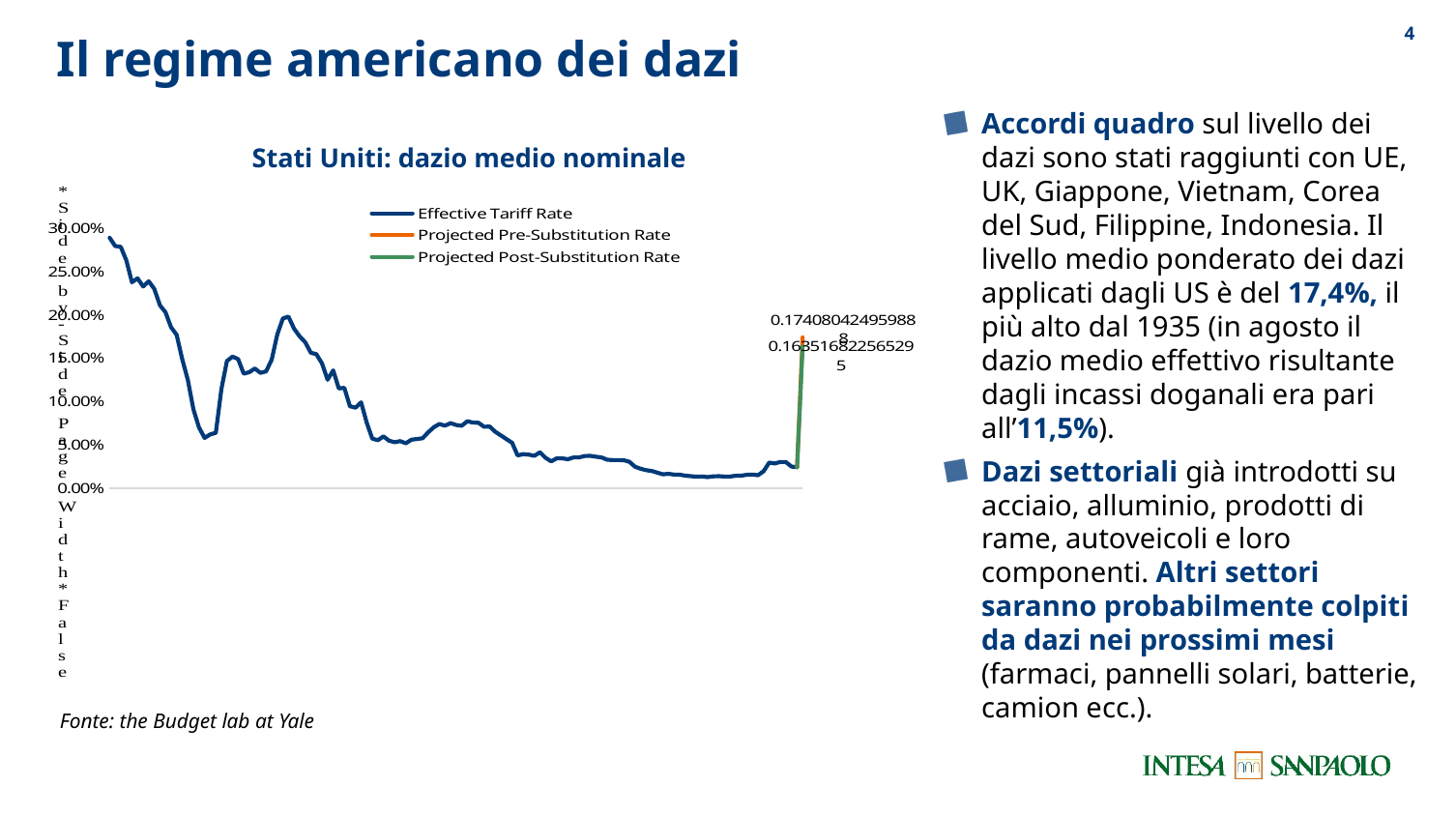
Which is larger: the Effective Tariff Rate at the far left of the chart or the Effective Tariff Rate just before the projected spike at the right? The value at the far left How many series does the legend of the chart list? 3 What kind of chart is shown on the slide? Line chart Does the Effective Tariff Rate line generally rise or fall from the left of the chart to the point just before the projected spike at the right? Fall Are the projected rates at the right end of the chart greater or less than 15.00%? greater What is the title of the chart on the slide? Stati Uniti: dazio medio nominale Is the Effective Tariff Rate at the far left of the chart greater or less than 30.00%? less Is the lowest point of the Effective Tariff Rate line greater or less than 5.00%? less What colour is the Effective Tariff Rate line in the chart? Dark blue